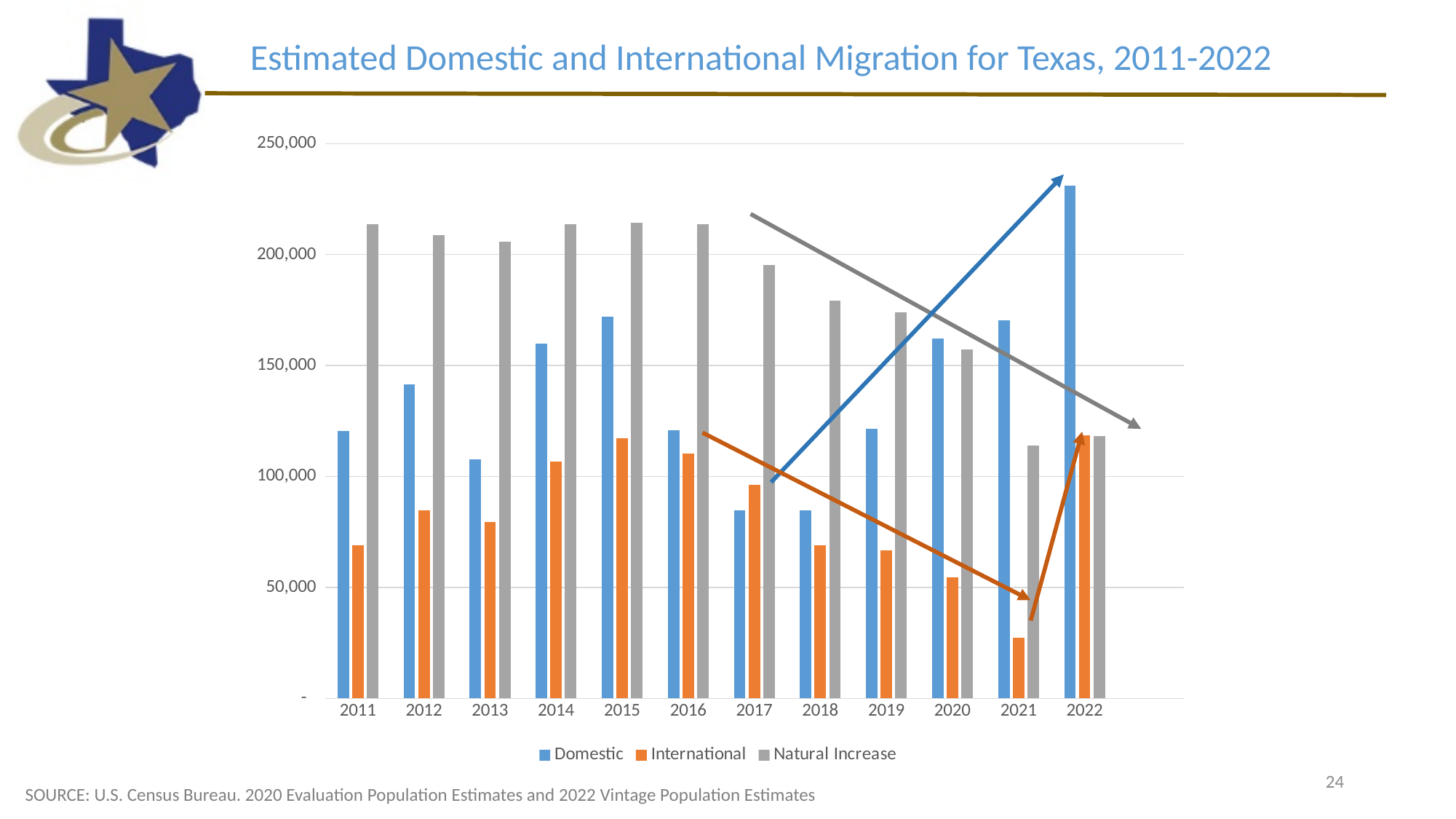
Is the Domestic value for 2017 greater or less than 100,000? less In which year is the Domestic value highest? 2022 In which year is the International value lowest? 2021 Is the International value for 2021 greater or less than 50,000? less In 2011, which is larger: Domestic or Natural Increase? Natural Increase In 2022, which is larger: Domestic or Natural Increase? Domestic Is the Domestic value for 2022 greater or less than 200,000? greater Does the Natural Increase series rise or fall from 2016 to 2021? Fall How many series does the legend list? 3 How many years are shown on the x axis? 12 What kind of chart is shown on the slide? Bar chart